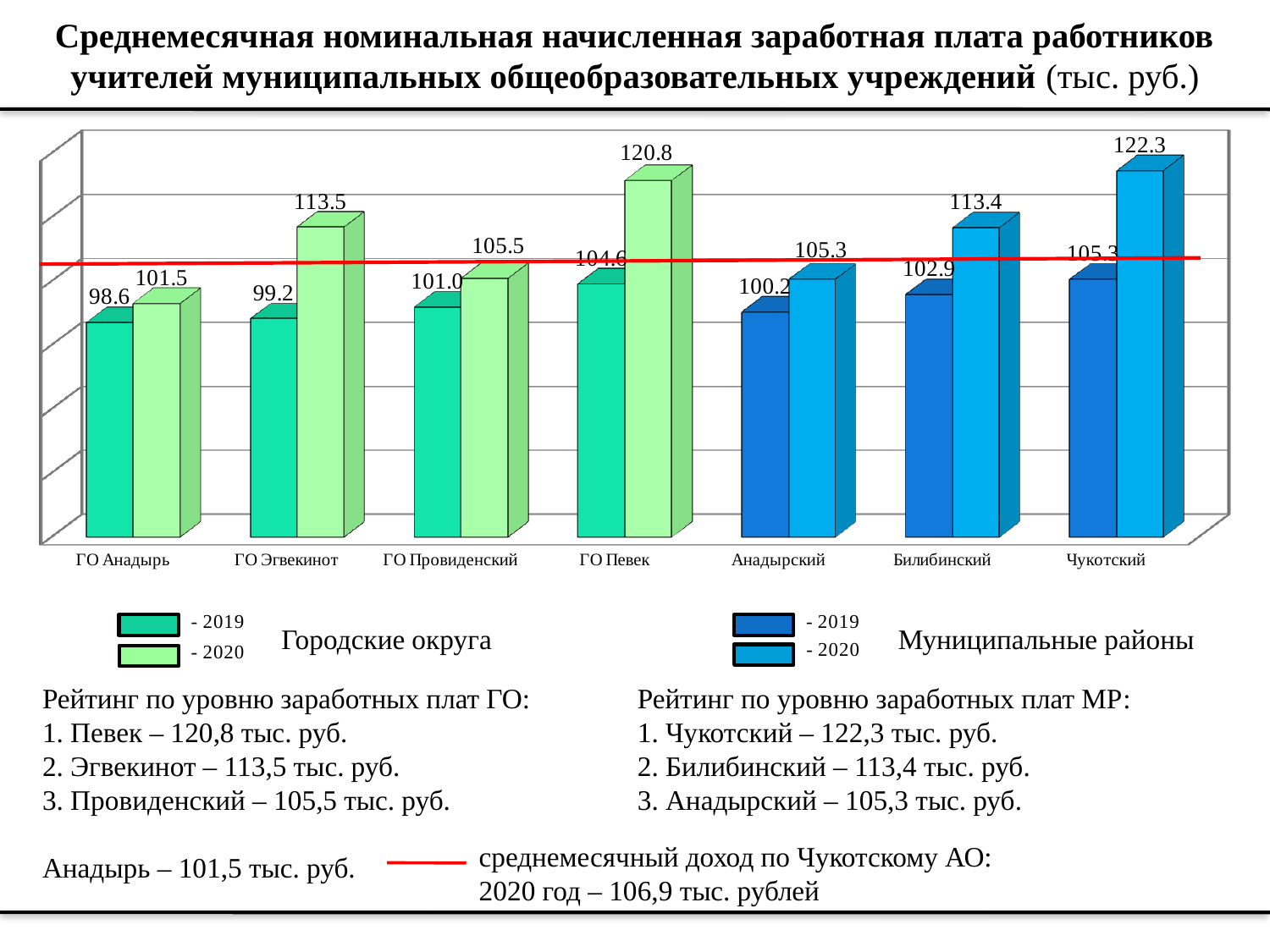
Which category has the highest 2020 value? Чукотский Do the 2020 values rise or fall from ГО Провиденский to ГО Певек? Rise What is the 2019 value for Чукотский? 105.3 What is the 2020 value for ГО Певек? 120.8 What is the difference between the 2020 and 2019 values for ГО Эгвекинот? 14.3 What is the 2020 value for Билибинский? 113.4 What is the 2019 value for ГО Анадырь? 98.6 Which is larger: the 2020 value for ГО Певек or the 2020 value for Билибинский? ГО Певек What kind of chart is shown on the slide? Bar chart Which category has the lowest 2019 value? ГО Анадырь What value does the red horizontal line on the chart represent? 106,9 тыс. рублей How many categories are shown on the x axis of the chart? 7